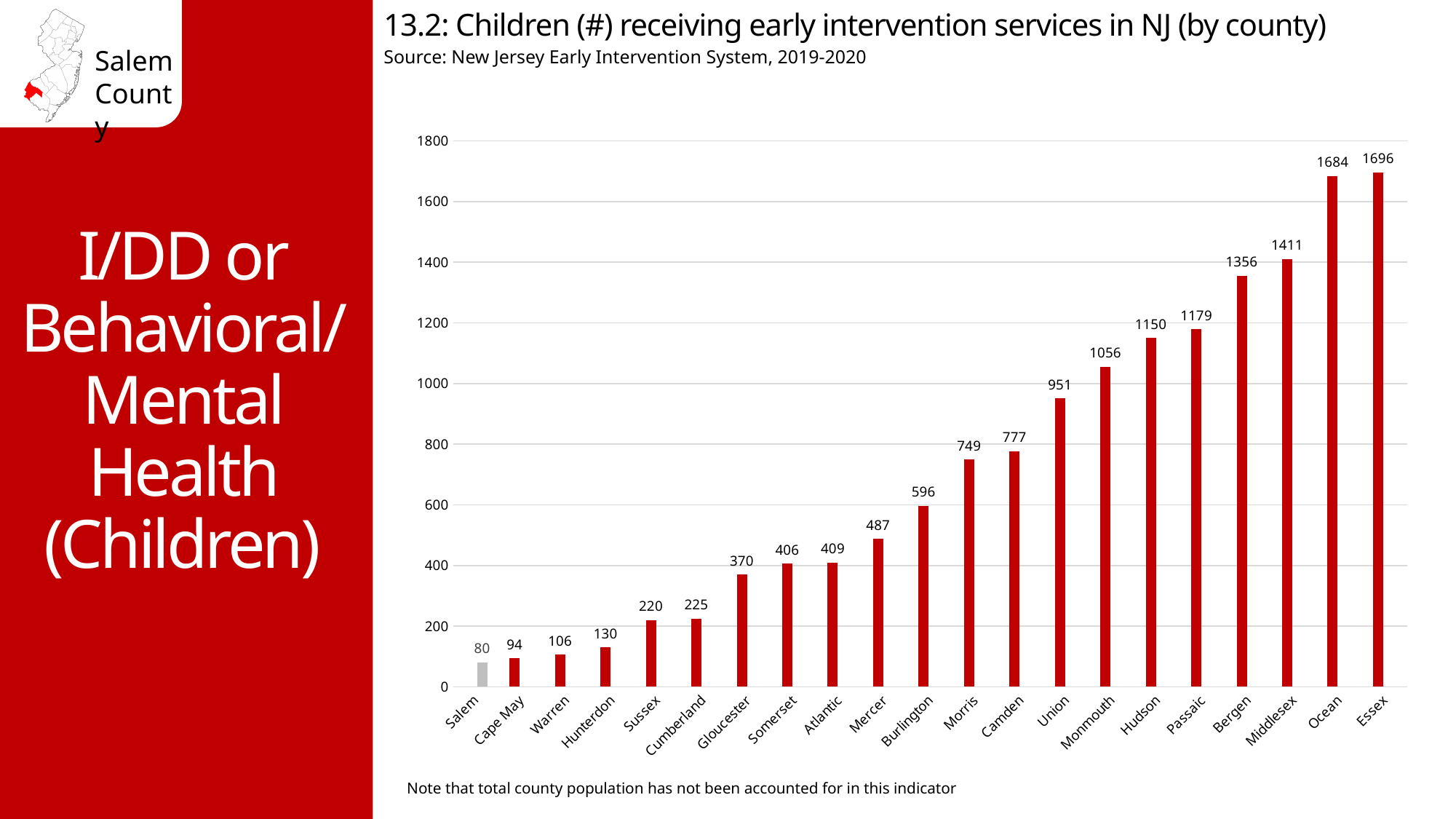
Which county has the highest number of children receiving early intervention services? Essex Is the value for Burlington greater or less than 600? less What type of chart is shown on the slide? bar chart How many counties are shown on the chart? 21 Which has a higher value, Hudson or Monmouth? Hudson What is the value shown for Mercer? 487 What is the value shown for Bergen? 1356 What is the difference between the values for Essex and Salem? 1616 How many children in Salem County are receiving early intervention services? 80 Do the values rise or fall moving from left to right along the x axis? rise Which county has the lowest number of children receiving early intervention services? Salem What is the difference between the values for Union and Morris? 202